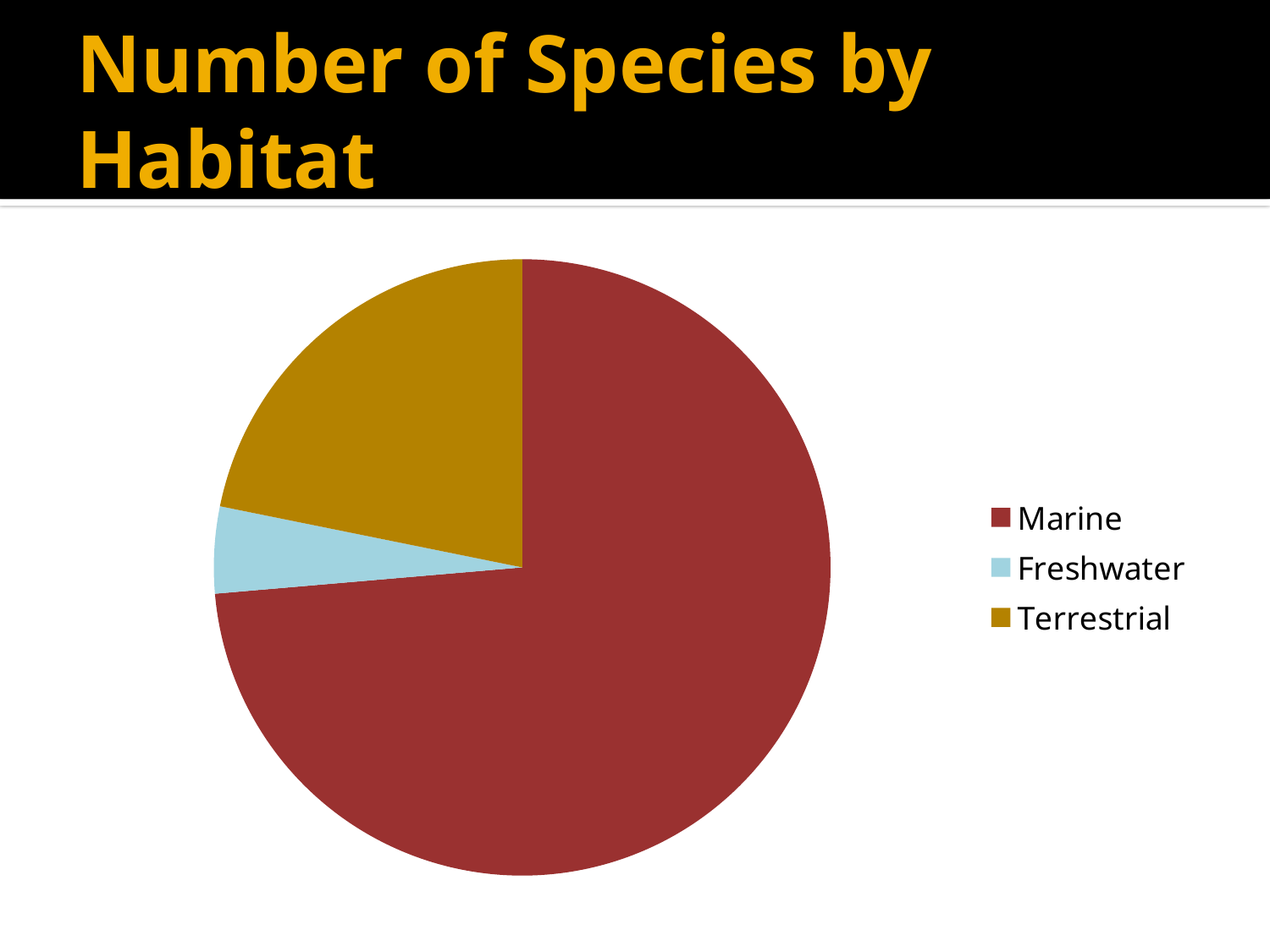
Which habitat has the smallest share of species in the pie chart? Freshwater How many slices does the pie chart have? 3 What is the title of the chart on the slide? Number of Species by Habitat Which habitat has the largest share of species in the pie chart? Marine Does the Marine slice take up more or less than half of the pie? more How many entries does the legend list? 3 Which has a larger share of the pie, Terrestrial or Freshwater? Terrestrial What kind of chart is shown on the slide? pie chart Which has a larger share of the pie, Marine or Terrestrial? Marine What colour is the Freshwater slice in the pie chart? light blue